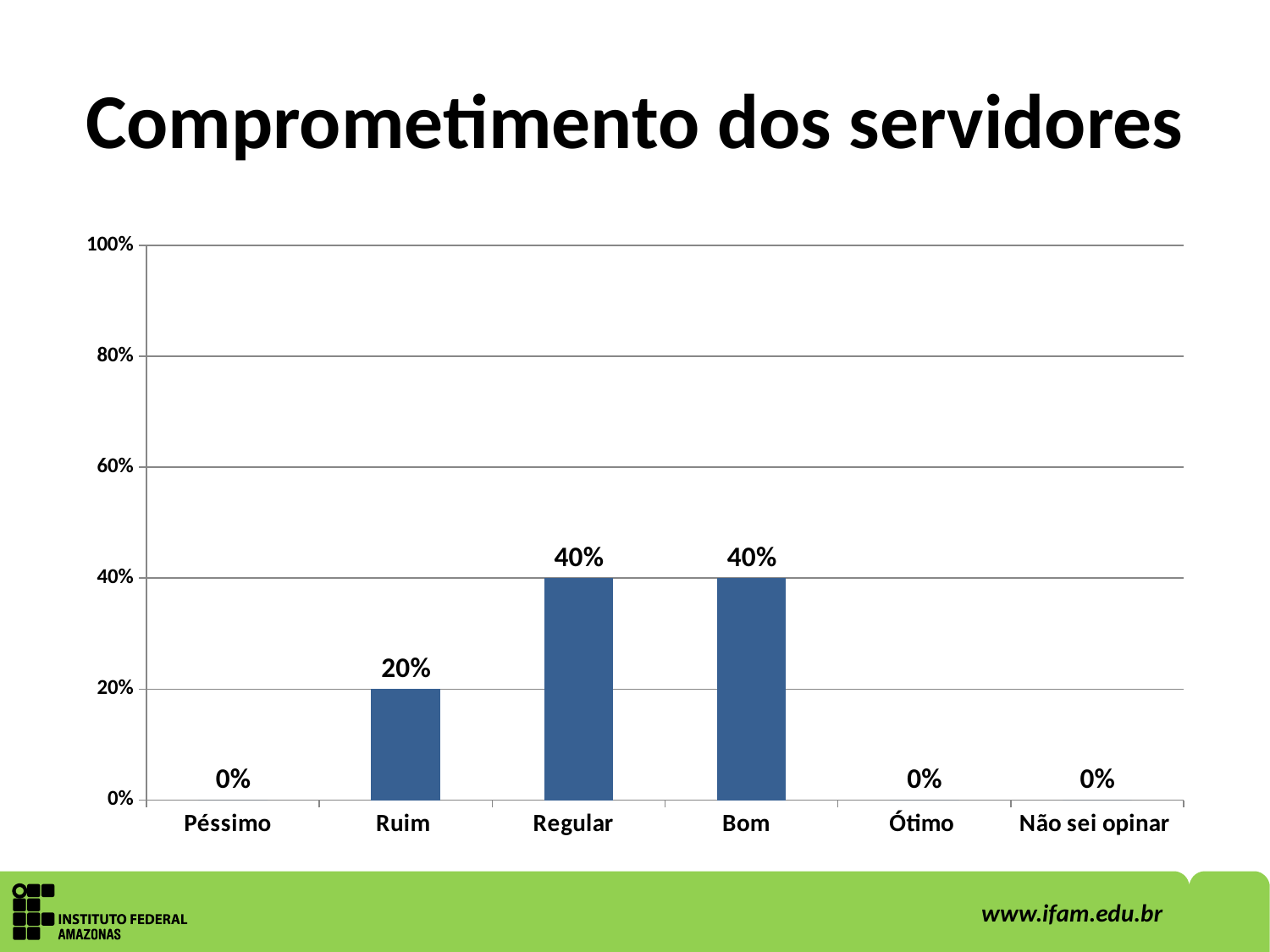
What is the value for Ruim? 20% Is the value for Regular greater or less than 60%? less How many categories are shown on the x axis? 6 Which category has the lowest non-zero value? Ruim What is the value for Regular? 40% How many categories have a value of 0%? 3 What kind of chart is shown on the slide? bar chart What is the value for Péssimo? 0% What is the value for Não sei opinar? 0% What is the difference between the values for Regular and Ruim? 20% What is the title of the slide? Comprometimento dos servidores Which is larger, the value for Bom or the value for Ruim? Bom